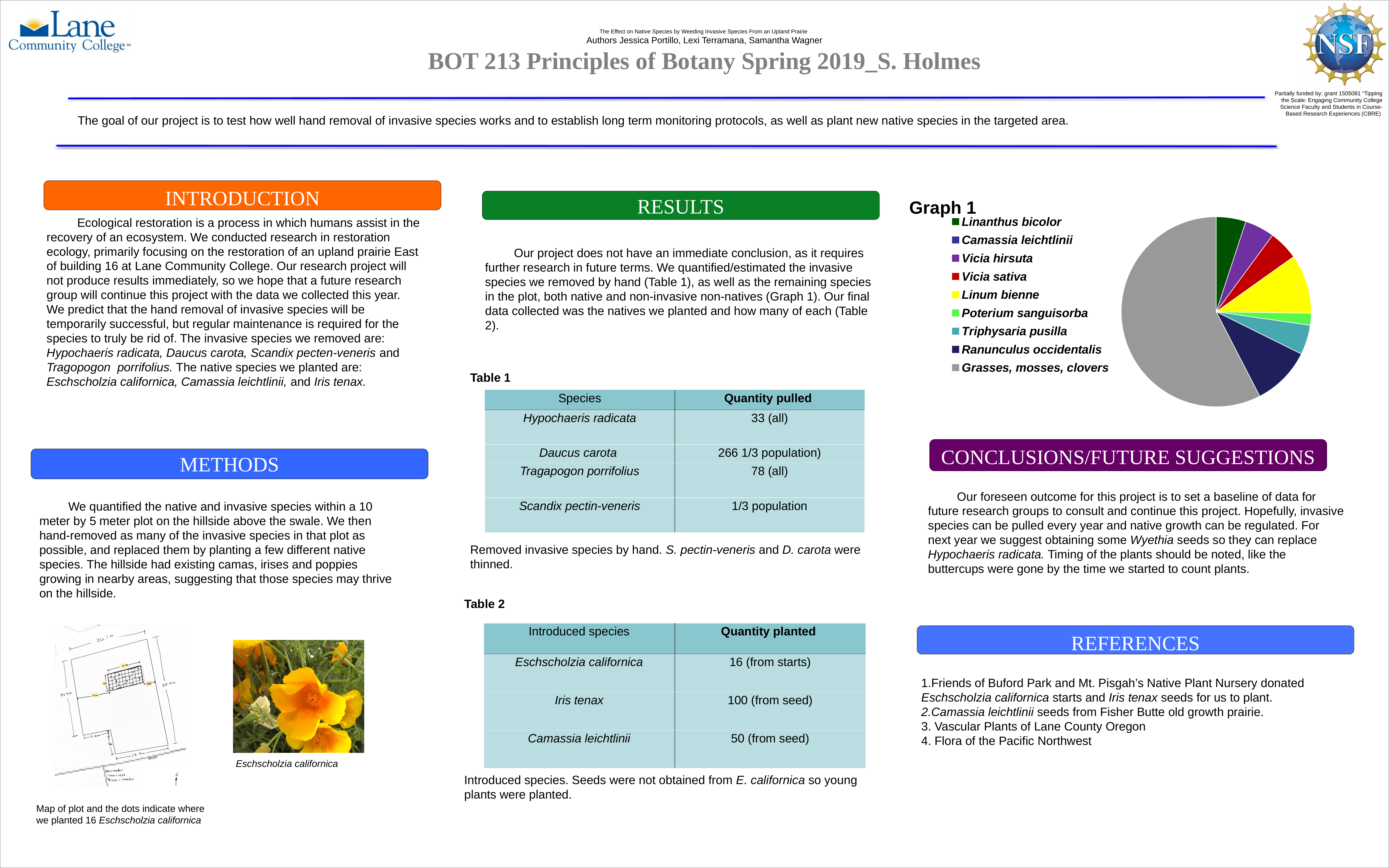
What is the title of the pie chart on the slide? Graph 1 In Graph 1, which slice is larger: Ranunculus occidentalis or Vicia sativa? Ranunculus occidentalis In Graph 1, which slice is larger: Triphysaria pusilla or Poterium sanguisorba? Triphysaria pusilla In Graph 1, which slice is larger: Grasses, mosses, clovers or Ranunculus occidentalis? Grasses, mosses, clovers What kind of chart is Graph 1? pie chart What colour represents Linum bienne in Graph 1? yellow How many categories does the legend of Graph 1 list? 9 Which category has the largest slice in Graph 1? Grasses, mosses, clovers